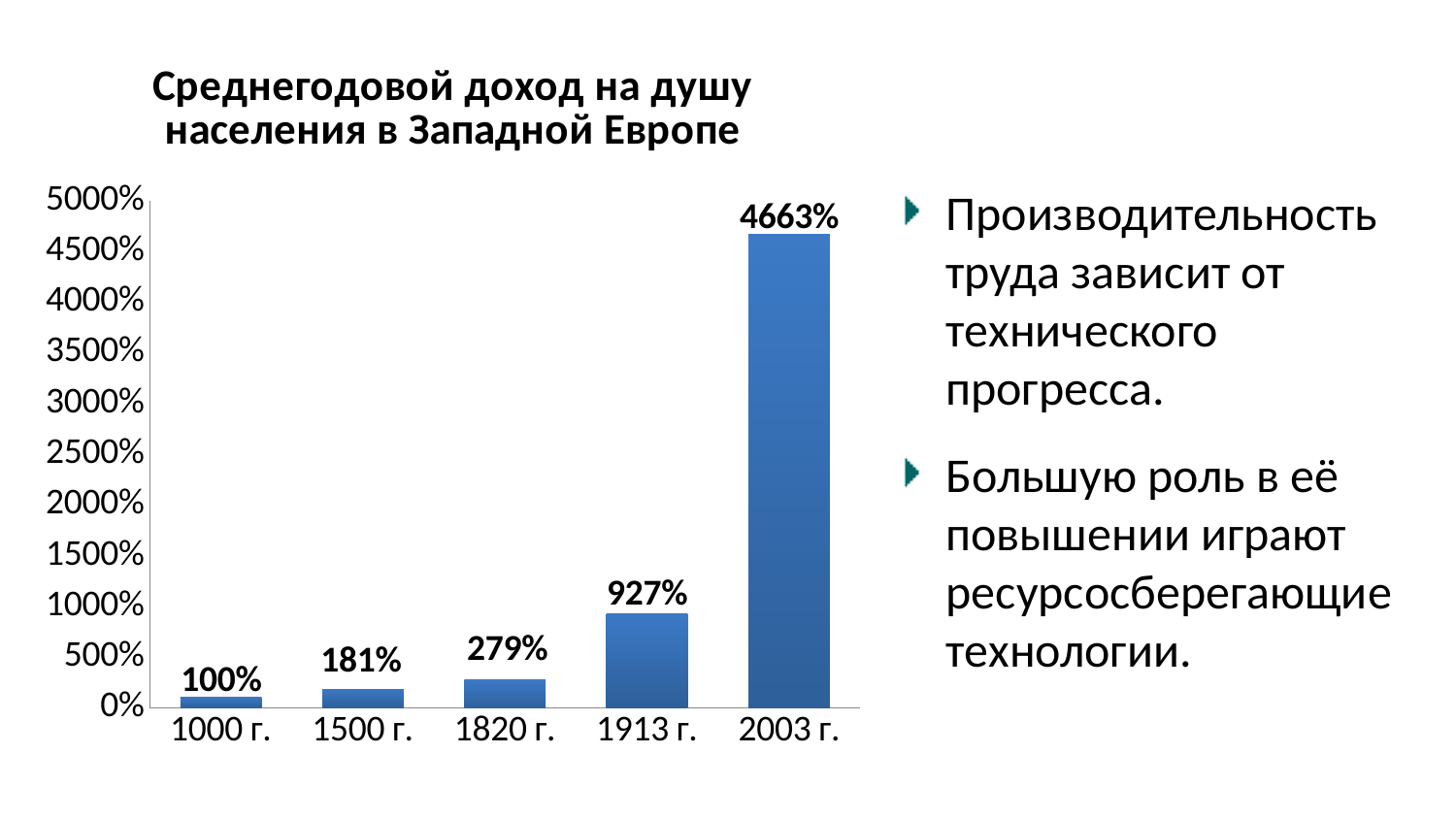
Is the value for 2003 г. greater or less than 4500%? greater Which category has the lowest value? 1000 г. What is the value for 1500 г.? 181% What kind of chart is this? bar chart What is the value for 1913 г.? 927% How many categories are shown on the x axis? 5 What is the value for 1820 г.? 279% Do the values rise or fall from 1000 г. to 2003 г.? rise Which category has the highest value? 2003 г. Which is larger, the value for 1913 г. or the value for 1820 г.? 1913 г. What is the difference between the values for 1820 г. and 1500 г.? 98% What is the difference between the values for 2003 г. and 1913 г.? 3736%